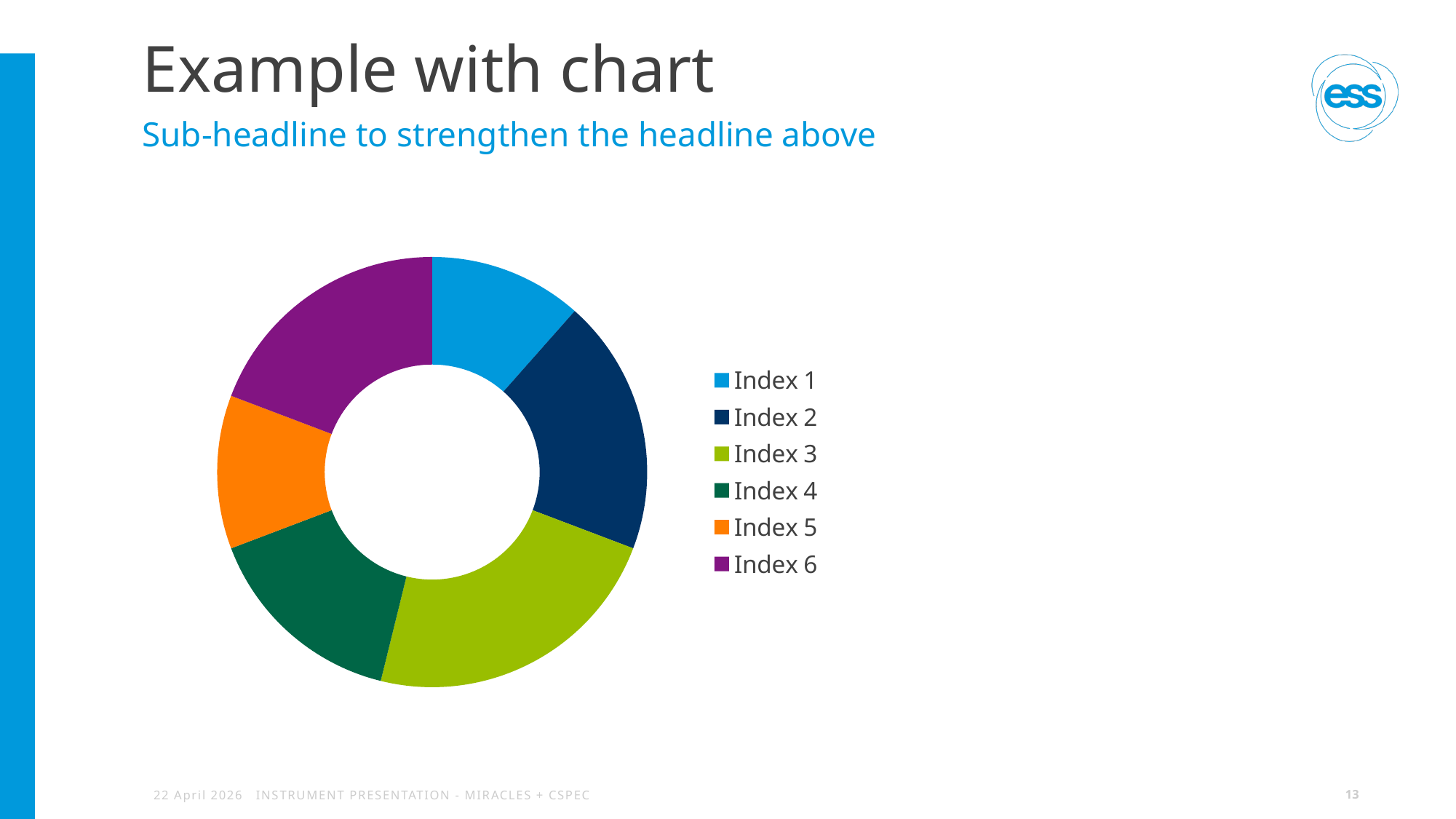
How many entries does the legend list? 6 What colour is the slice for Index 5? Orange Which slice is larger, Index 3 or Index 5? Index 3 Which category has the largest slice in the doughnut chart? Index 3 Which slice is larger, Index 6 or Index 1? Index 6 Which legend entry is shown in purple? Index 6 How many categories does the doughnut chart show? 6 Which slice is larger, Index 4 or Index 3? Index 3 What kind of chart is shown on the slide? Doughnut chart